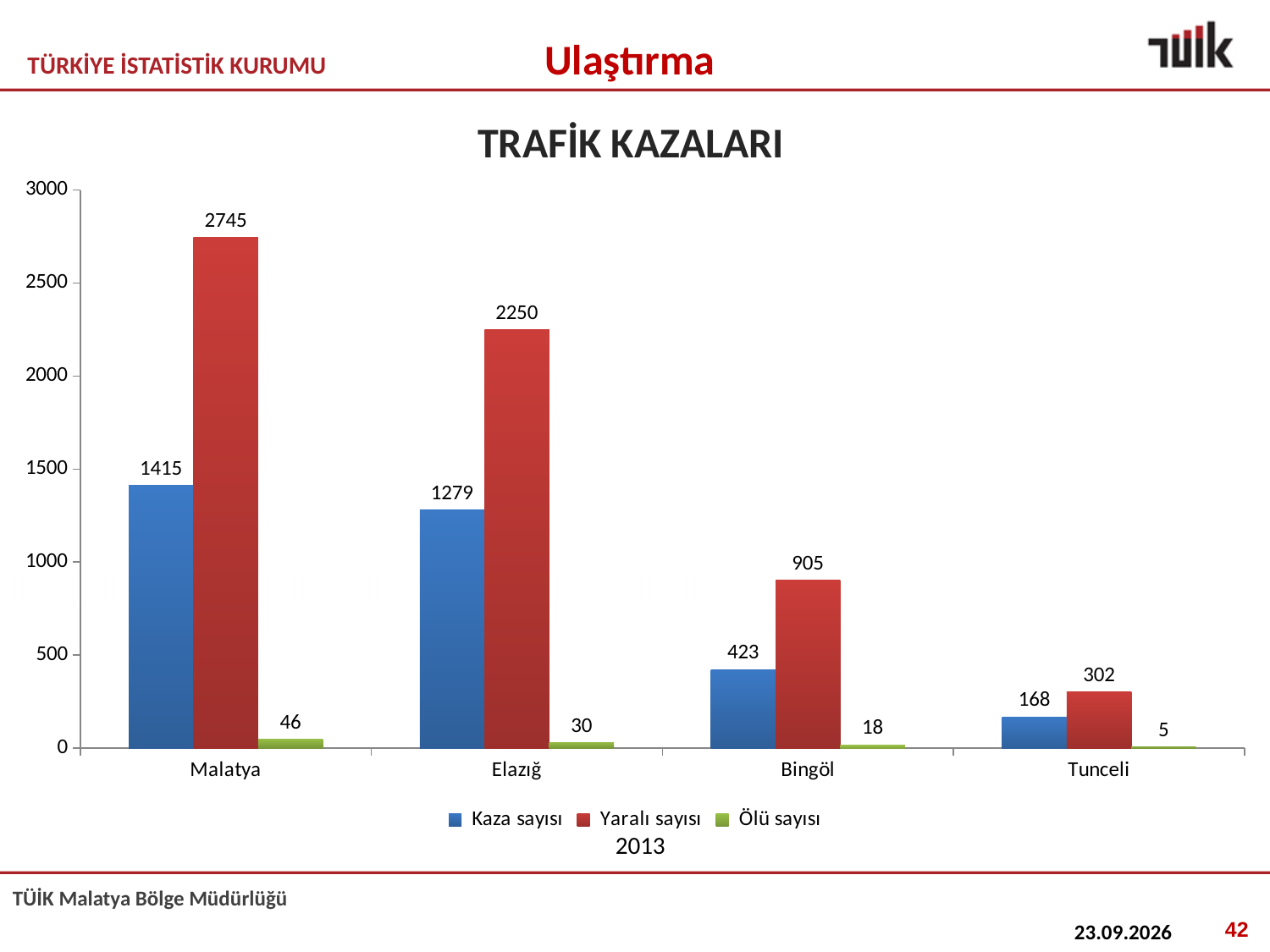
What is the title of the chart? TRAFİK KAZALARI Which province has the lowest Kaza sayısı? Tunceli Which is larger, the Yaralı sayısı for Bingöl or the Kaza sayısı for Elazığ? Kaza sayısı for Elazığ What is the Ölü sayısı value for Bingöl? 18 What is the Yaralı sayısı value for Tunceli? 302 What is the Yaralı sayısı value for Elazığ? 2250 What is the Kaza sayısı value for Malatya? 1415 How many provinces are shown on the x axis? 4 How many series does the legend list? 3 What kind of chart is shown on the slide? Bar chart What is the difference between the Kaza sayısı values for Malatya and Elazığ? 136 Which province has the highest Yaralı sayısı? Malatya